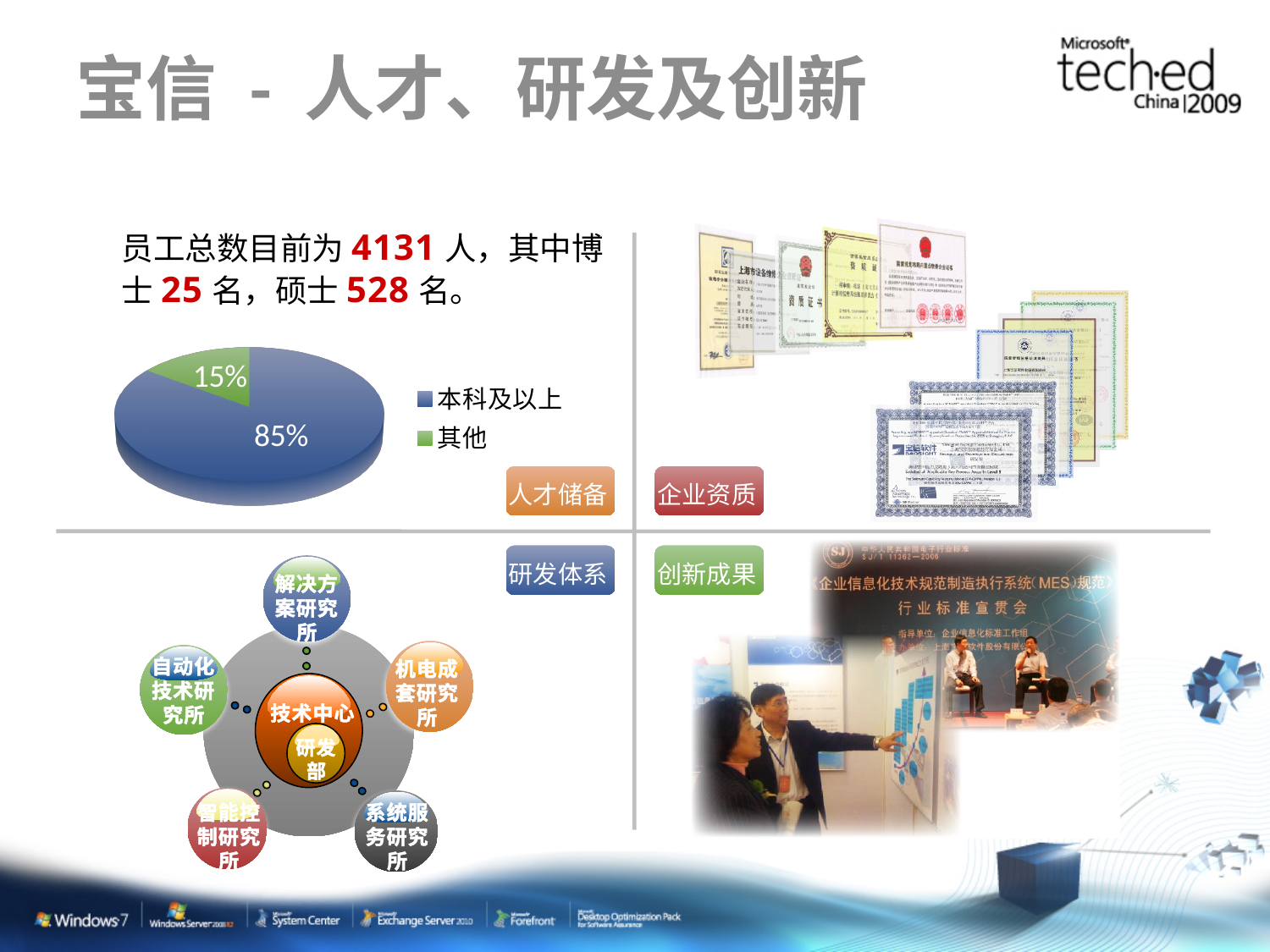
Is the share for 其他 greater or less than 50%? less What is the difference in percentage points between the 本科及以上 slice and the 其他 slice? 70 Which is larger in the pie chart, 本科及以上 or 其他? 本科及以上 What colour is the 其他 slice in the pie chart? green What share of the pie does 本科及以上 represent? 85% How many entries does the pie chart's legend list? 2 What colour is the 本科及以上 slice in the pie chart? blue What share of the pie does 其他 represent? 15% What kind of chart is shown on the left side of the slide? pie chart Which slice of the pie chart is the smallest? 其他 How many slices does the pie chart have? 2 Which slice of the pie chart is the largest? 本科及以上